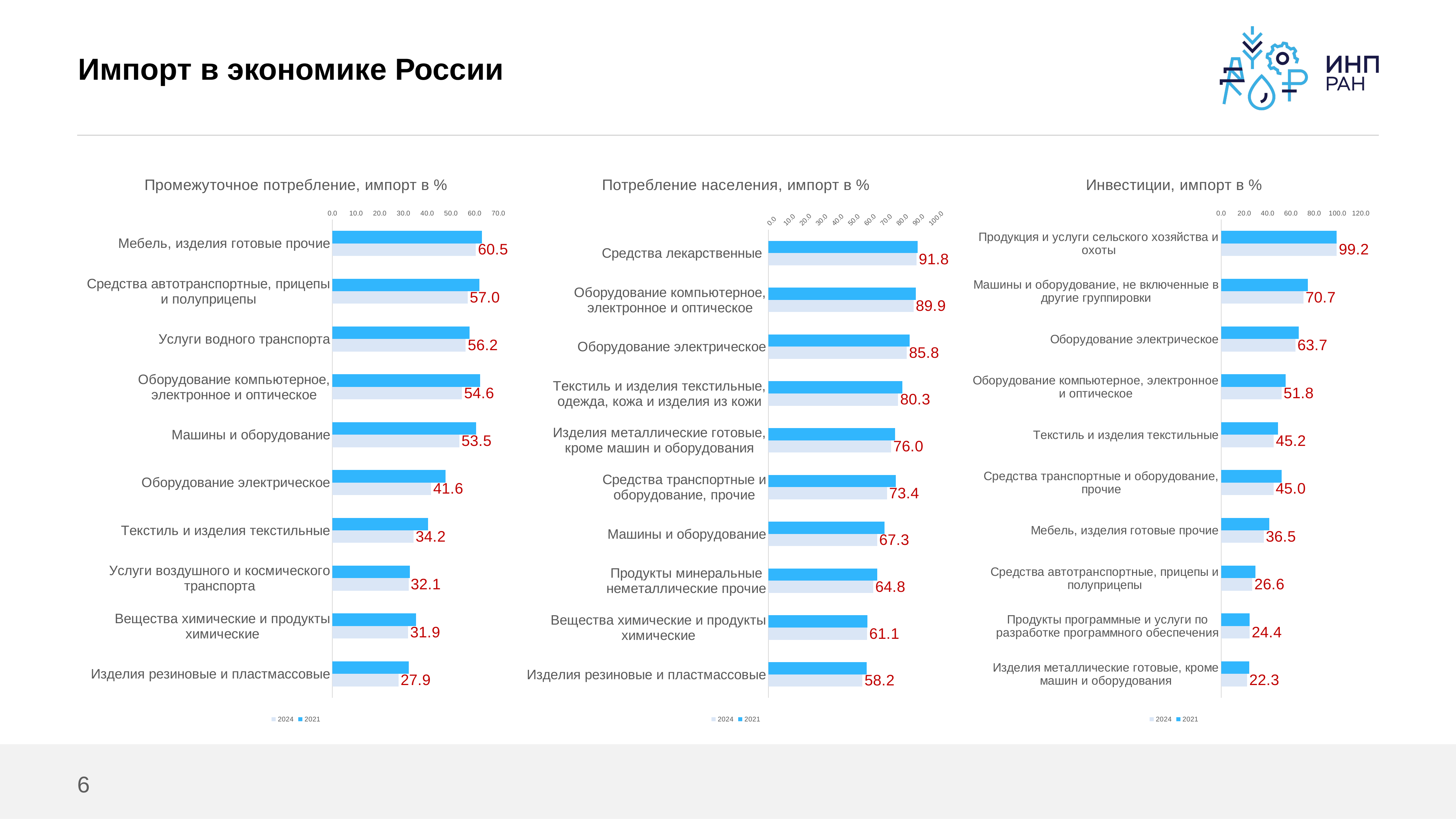
In the chart 'Промежуточное потребление, импорт в %', which category has the lowest labelled value? Изделия резиновые и пластмассовые In the chart 'Инвестиции, импорт в %', which category has the highest labelled value? Продукция и услуги сельского хозяйства и охоты In the chart 'Инвестиции, импорт в %', which has the larger labelled value: 'Мебель, изделия готовые прочие' or 'Средства автотранспортные, прицепы и полуприцепы'? Мебель, изделия готовые прочие How many categories are shown in the chart 'Потребление населения, импорт в %'? 10 How many series does the legend of the chart 'Инвестиции, импорт в %' list? 2 In the chart 'Потребление населения, импорт в %', what is the labelled 2024 value for 'Средства лекарственные'? 91.8 In the chart 'Потребление населения, импорт в %', what is the difference between the labelled values for 'Средства лекарственные' and 'Изделия резиновые и пластмассовые'? 33.6 Which years are listed in the legend of the chart 'Потребление населения, импорт в %'? 2024 and 2021 In the chart 'Промежуточное потребление, импорт в %', is the 2021 (blue) bar for 'Оборудование электрическое' greater or less than 40.0? greater In the chart 'Инвестиции, импорт в %', what is the labelled 2024 value for 'Оборудование электрическое'? 63.7 What type of chart is 'Промежуточное потребление, импорт в %'? Bar chart In the chart 'Промежуточное потребление, импорт в %', what is the labelled 2024 value for 'Мебель, изделия готовые прочие'? 60.5